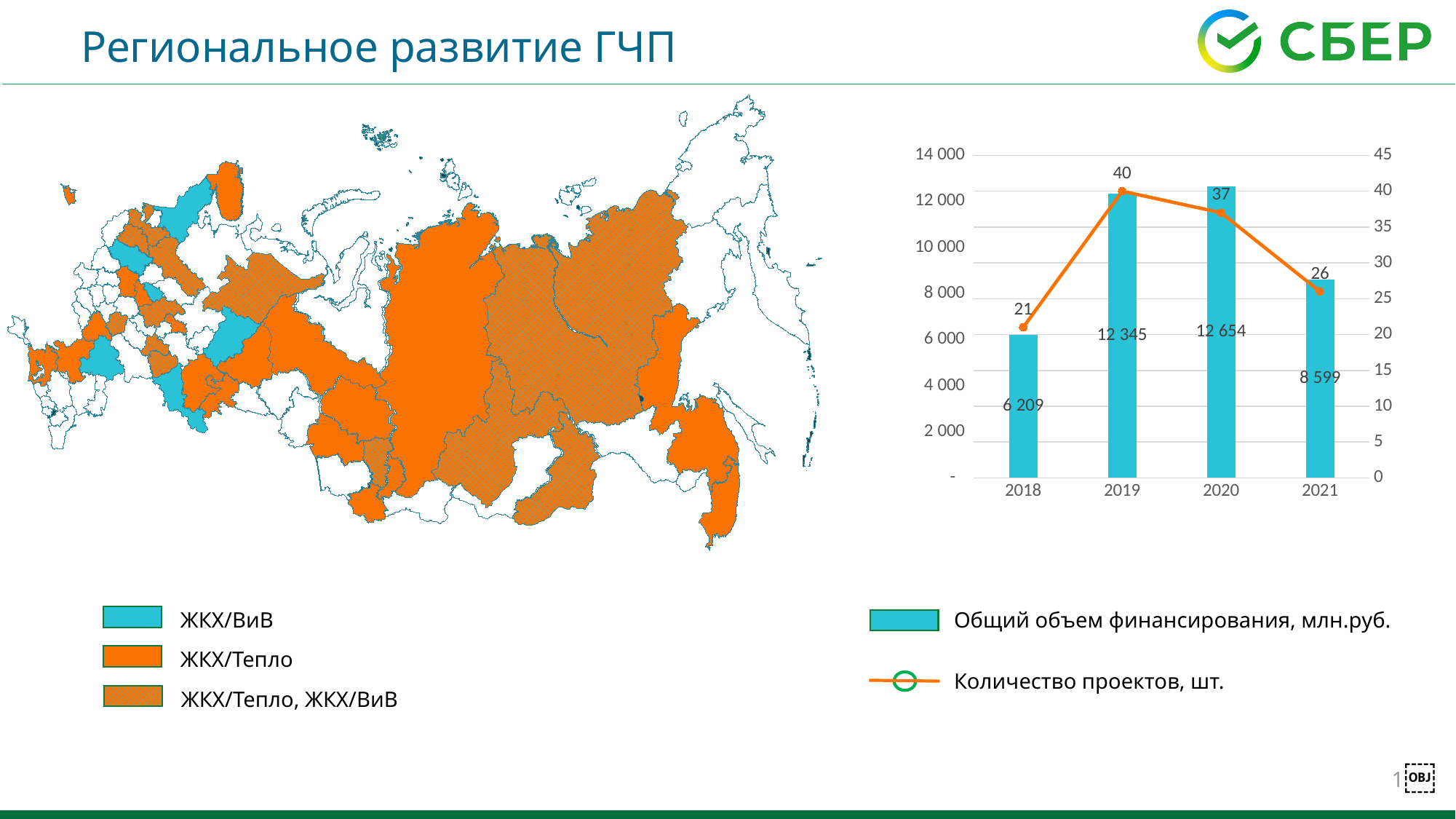
In the bar and line chart, what is the total funding (Общий объем финансирования) for 2019? 12 345 What kind of chart is shown on the right side of the slide? Combined bar and line chart In the bar and line chart, which year has the lowest number of projects? 2018 In the bar and line chart, which year has the highest total funding? 2020 In the bar and line chart, how many projects (Количество проектов) are shown for 2020? 37 In the bar and line chart, what is the difference in funding between 2020 and 2019? 309 How many series does the legend of the bar and line chart list? 2 In the bar and line chart, does the number of projects rise or fall from 2019 to 2021? Fall In the bar and line chart, what is the funding value for 2018? 6 209 How many years are shown on the x axis of the bar and line chart? 4 In the bar and line chart, which year has higher funding, 2018 or 2021? 2021 In the bar and line chart, how many more projects were there in 2019 than in 2021? 14